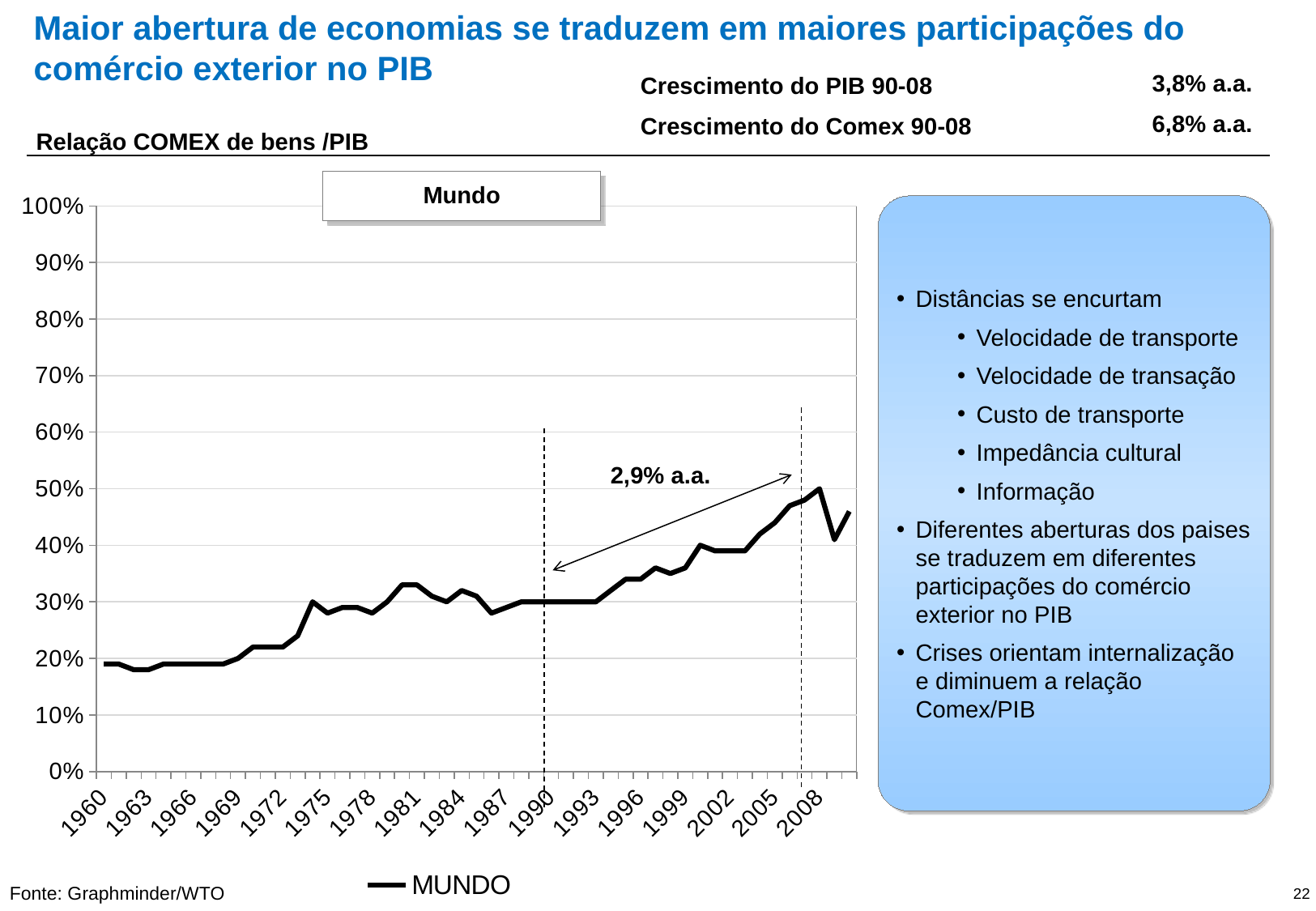
What is the name of the series shown in the chart legend? MUNDO What is the title shown in the box above the chart? Mundo Does the COMEX/PIB ratio generally rise or fall from 1960 to 2008? rise Is the value for 1990 greater or less than 40%? less Is the value for 1981 greater or less than 20%? greater Is the value for 1960 greater or less than 30%? less How many year labels are shown on the x axis? 17 Which year has the larger value, 1990 or 2005? 2005 How many series does the chart legend list? 1 Which year has the larger value, 1960 or 2008? 2008 What kind of chart is shown on the slide? line chart